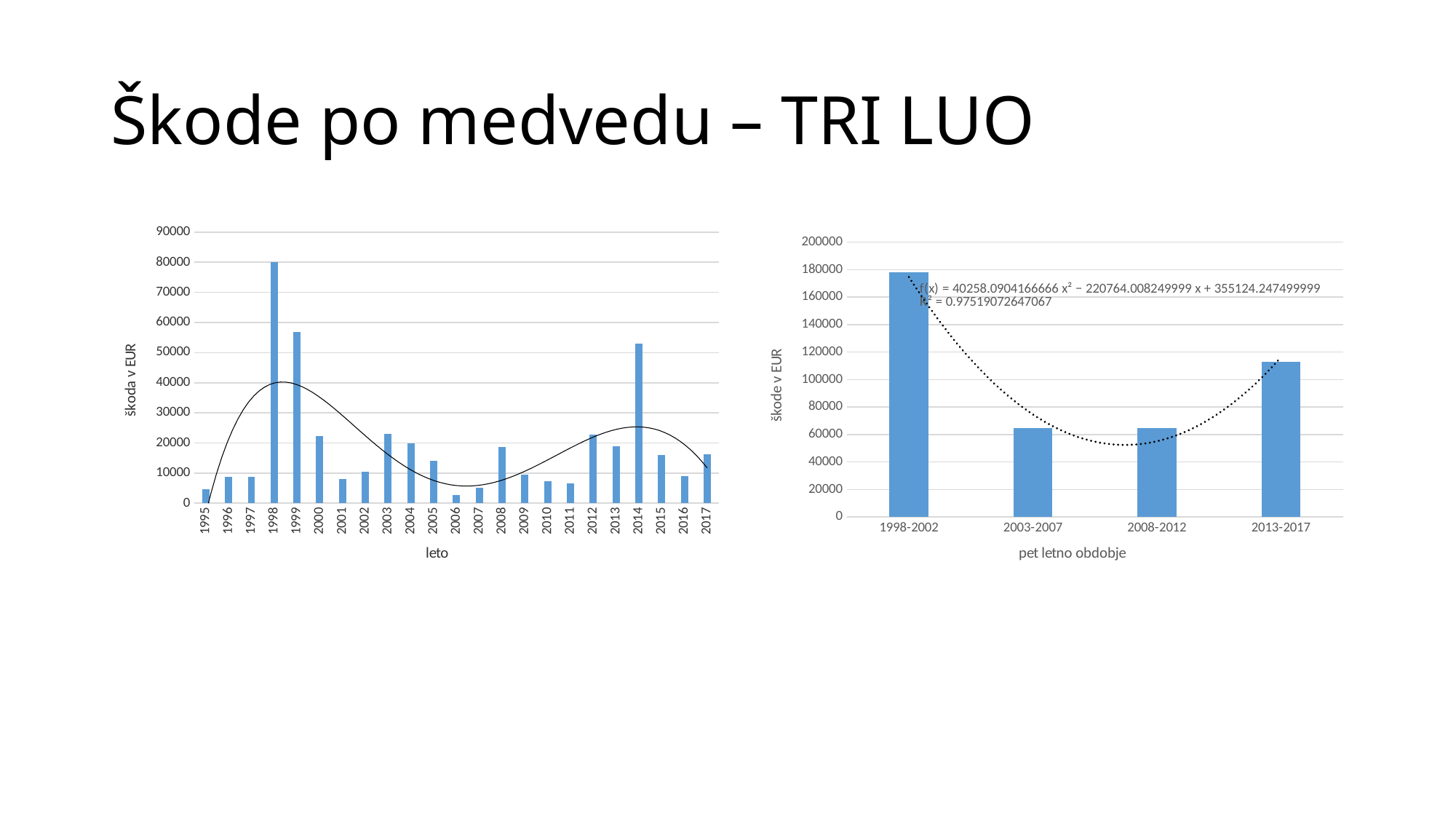
In the left chart, which year has the lowest value? 2006 What is the x-axis title of the right chart? pet letno obdobje How many periods are shown in the right chart? 4 In the left chart, is the value for 2006 greater or less than 10000? less How many years are shown on the x axis of the left chart? 23 In the left chart, which year has the highest value? 1998 In the right chart, is the value for 2003-2007 greater or less than 80000? less In the left chart, is the value for 1998 greater or less than 70000? greater In the left chart, which is larger, the value for 1999 or the value for 2014? 1999 In the right chart, which five-year period has the highest value? 1998-2002